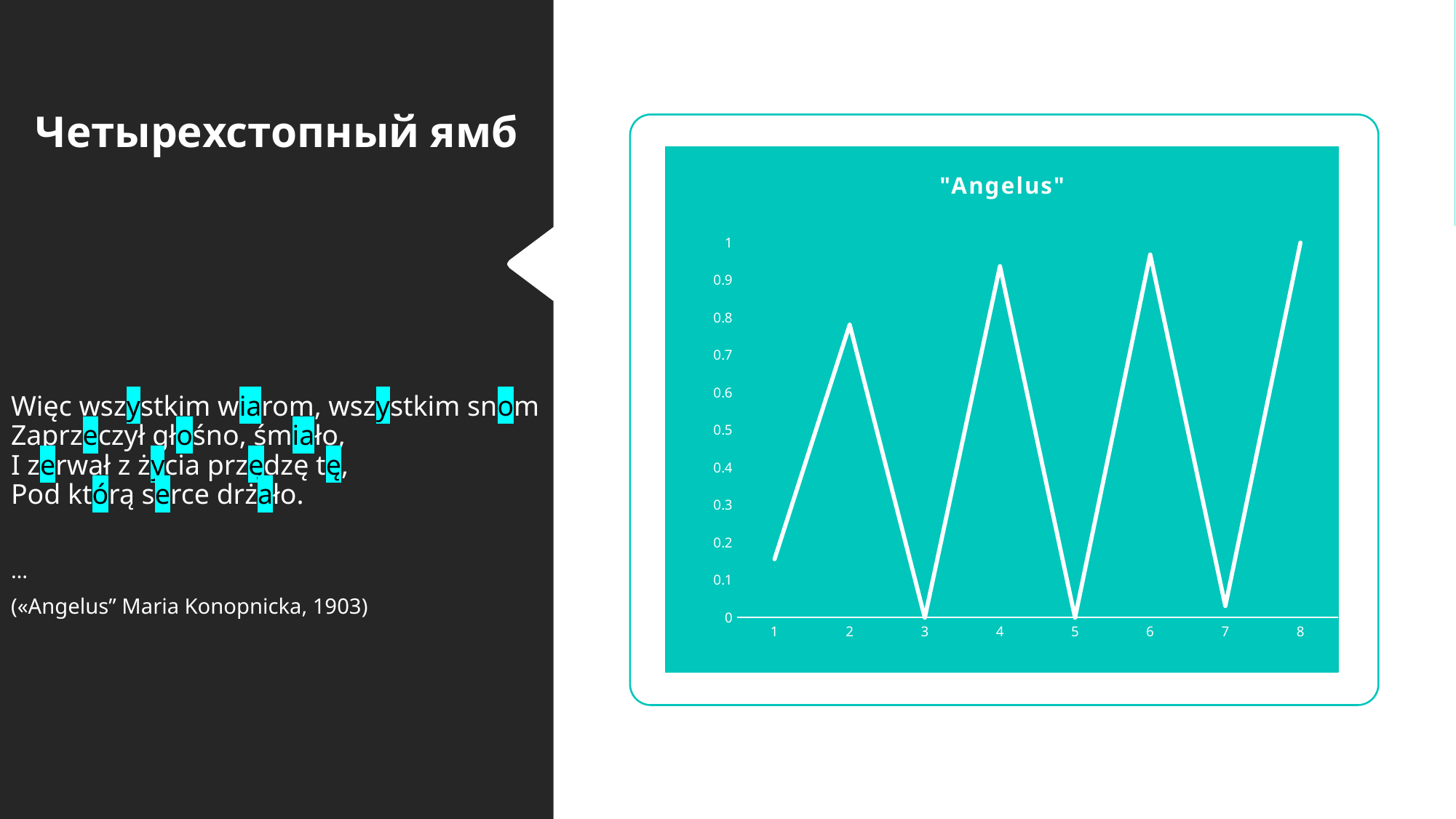
Is the value at x = 2 greater or less than 0.5? greater What is the value at x = 3 on the chart? 0 How many points are plotted along the x axis of the chart? 8 What is the value at x = 8 on the chart? 1 Is the value at x = 1 greater or less than 0.5? less What is the title of the chart? "Angelus" What kind of chart is shown on the slide? line chart Is the value at x = 4 greater or less than 0.8? greater Which is larger, the value at x = 2 or the value at x = 4? x = 4 Does the value rise or fall from x = 1 to x = 2? rise What is the value at x = 5 on the chart? 0